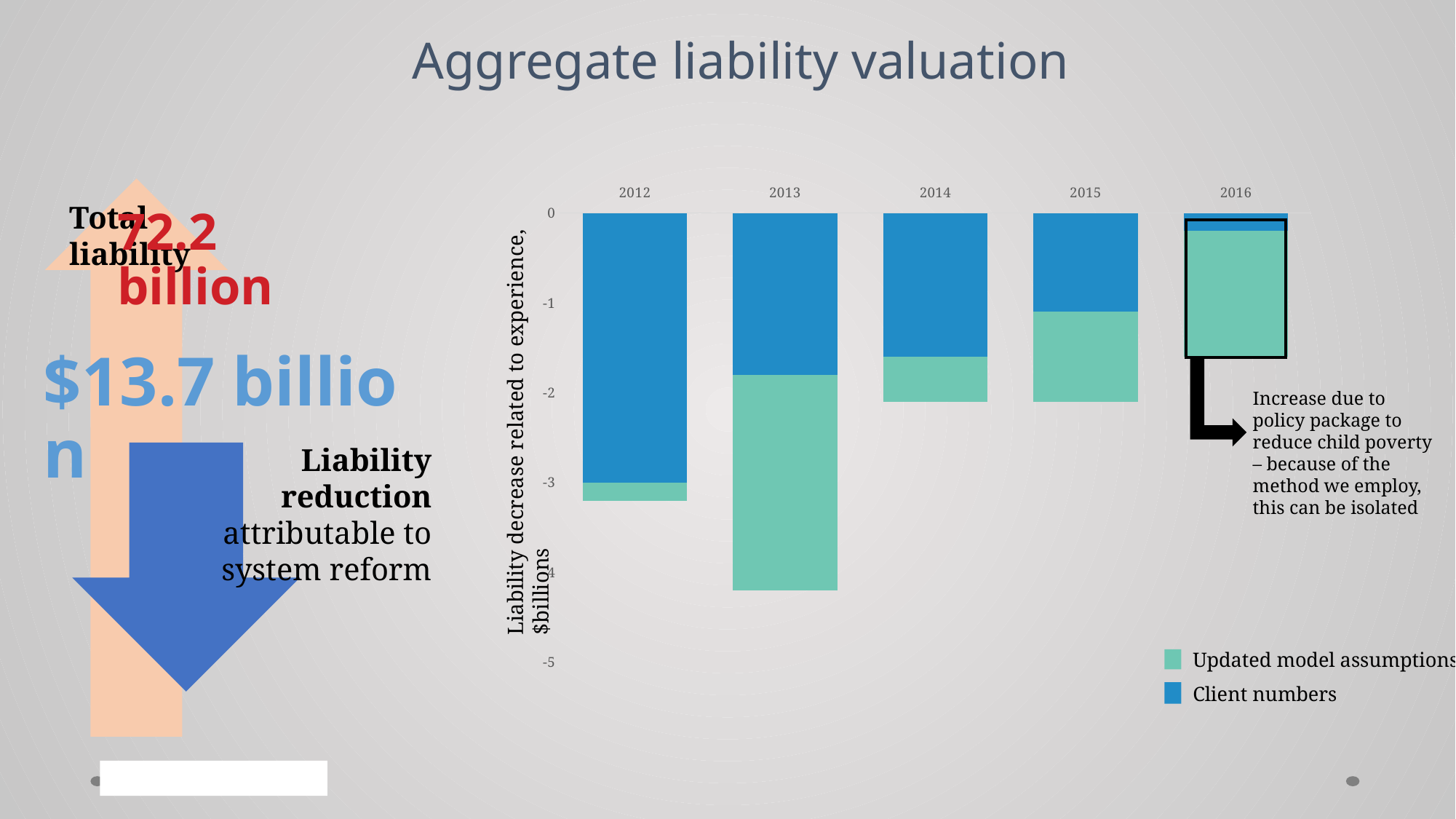
What is the label on the vertical axis of the chart? Liability decrease related to experience, $billions How many years are shown on the x axis of the chart? 5 What are the two series named in the chart legend? Updated model assumptions; Client numbers Is the total value for 2016 greater or less than -2? greater Which year has the largest total liability decrease (the longest stacked bar)? 2013 How many series does the chart legend list? 2 What kind of chart is shown on the slide? Stacked bar chart Which year has the larger total liability decrease, 2012 or 2013? 2013 From 2013 to 2016, do the total stacked bars get longer or shorter? shorter Which year has the larger Client numbers segment, 2012 or 2015? 2012 Which year has the smallest total liability decrease (the shortest stacked bar)? 2016 Is the total value for 2013 greater or less than -4? less